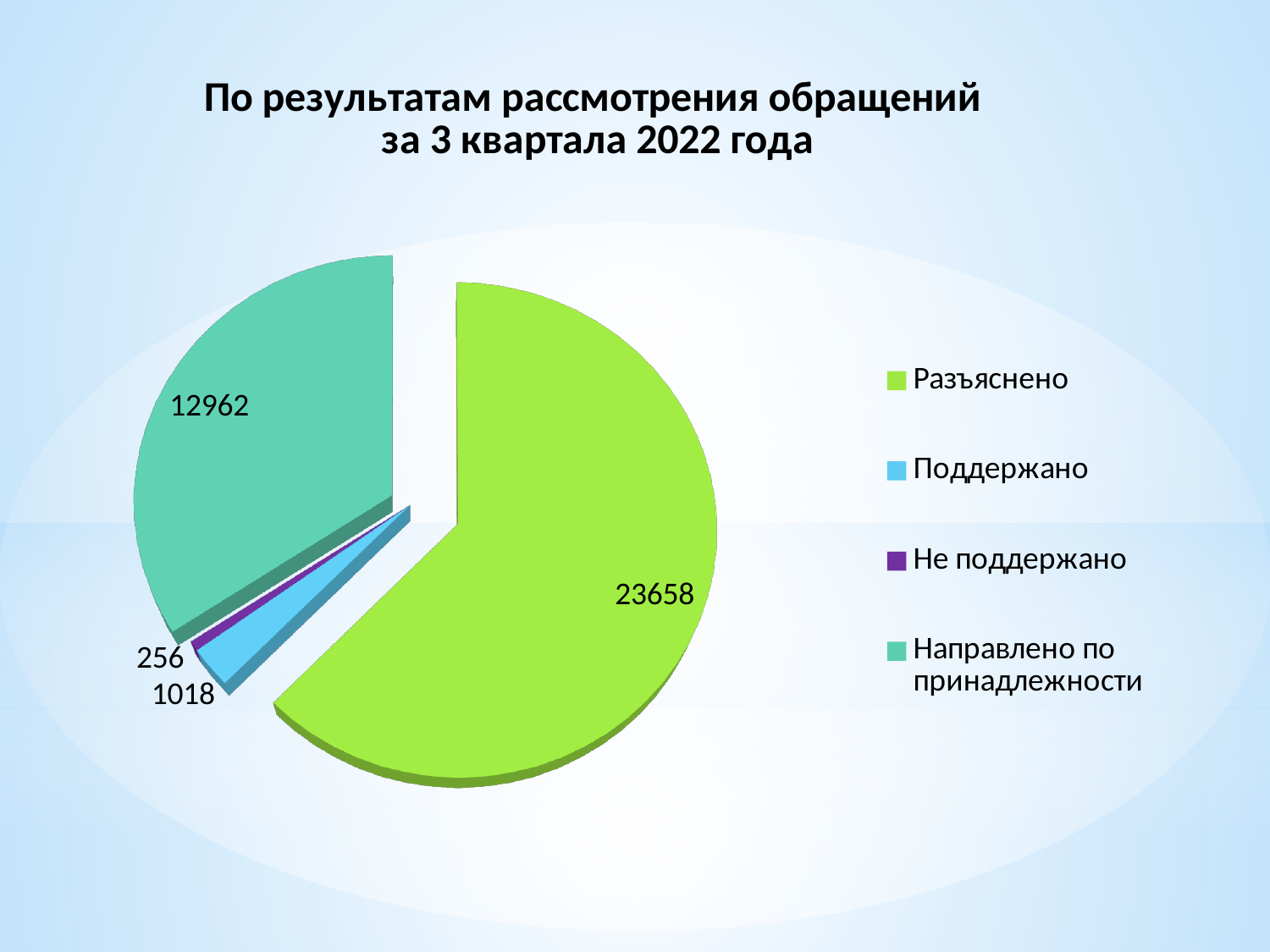
Which category has the largest slice of the pie? Разъяснено What type of chart is shown on the slide? pie chart What is the value for Не поддержано? 256 What is the total of all four slices in the pie chart? 37894 What is the difference between the values for Поддержано and Не поддержано? 762 Which is larger, the value for Поддержано or the value for Не поддержано? Поддержано Which category has the smallest slice of the pie? Не поддержано What is the value for Поддержано? 1018 What is the value for Разъяснено? 23658 How many categories does the pie chart have? 4 What is the value for Направлено по принадлежности? 12962 What is the difference between the values for Разъяснено and Направлено по принадлежности? 10696